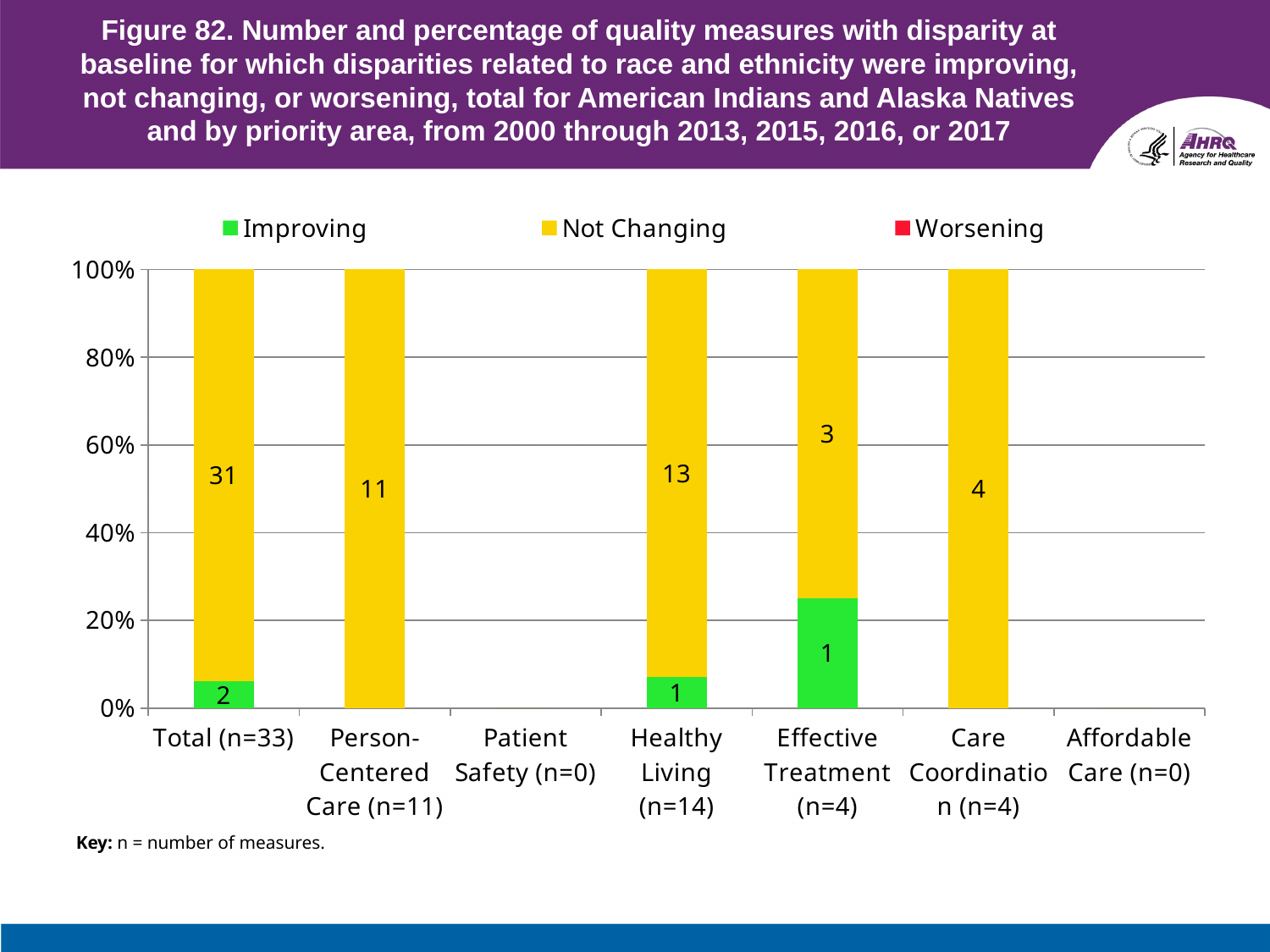
How many series does the legend list? 3 Which priority area has the highest Not Changing count among the priority areas (excluding Total)? Healthy Living (n=14) What is the Not Changing value shown for Person-Centered Care (n=11)? 11 What is the Not Changing value shown for Healthy Living (n=14)? 13 How many measures are labeled as Not Changing in the Total (n=33) bar? 31 What is the Improving value shown for Effective Treatment (n=4)? 1 How many categories are shown on the x axis? 7 How many measures are labeled as Improving in the Total (n=33) bar? 2 Is the Improving share of the Effective Treatment (n=4) bar greater or less than 20%? greater What is the difference between the Not Changing and Improving counts for Healthy Living (n=14)? 12 What kind of chart is shown on the slide? Stacked bar chart Which is larger: the Not Changing count for Person-Centered Care or for Care Coordination? Person-Centered Care